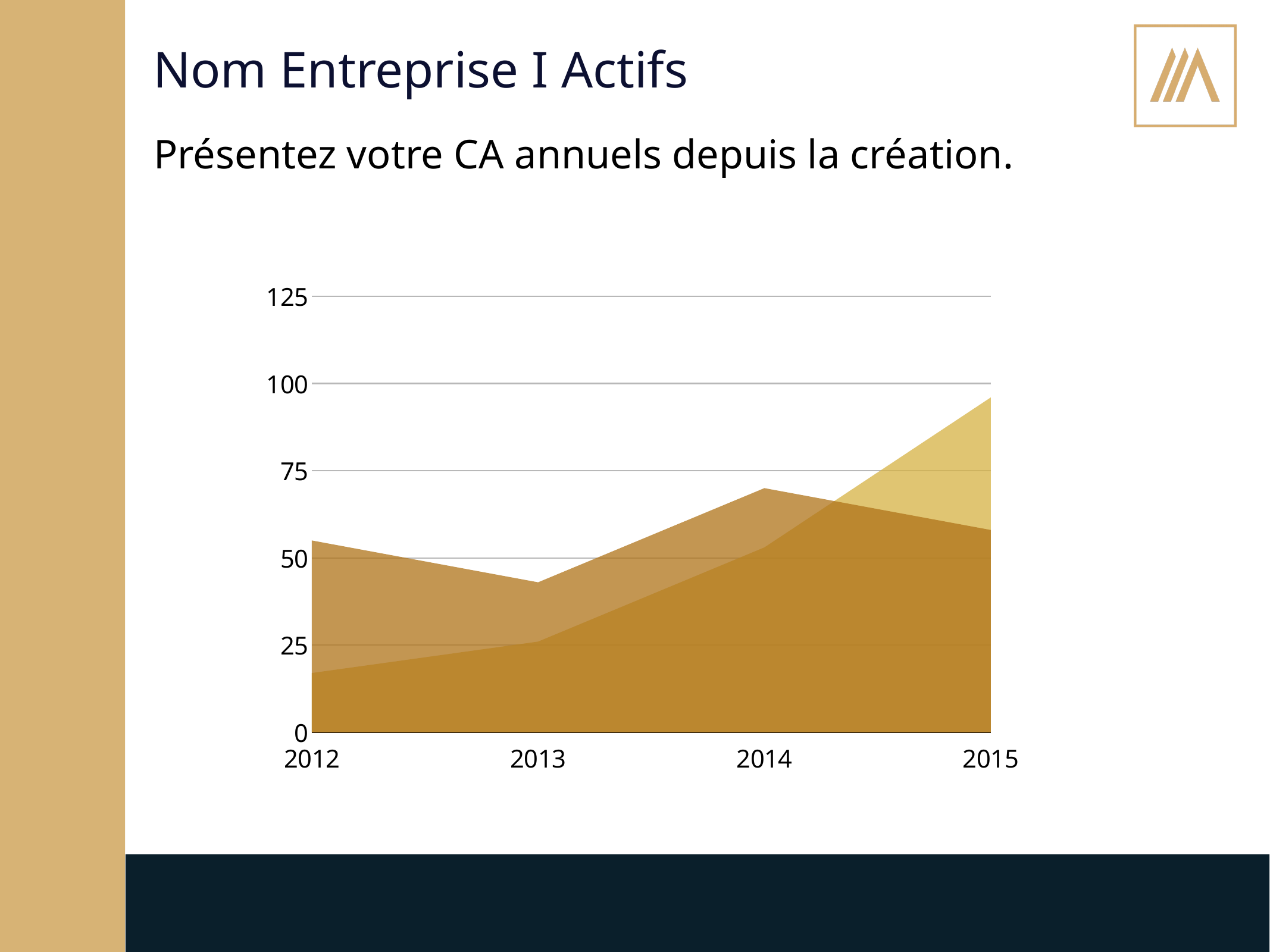
Is the highest plotted value in 2013 greater or less than 50? less Is the highest plotted value in 2014 greater or less than 75? less What is the first year shown on the x axis of the chart? 2012 What is the last year shown on the x axis of the chart? 2015 What kind of chart is shown on the slide? area chart What is the highest value labelled on the y axis of the chart? 125 Is the lowest plotted value in 2012 greater or less than 25? less How many years are shown on the x axis of the chart? 4